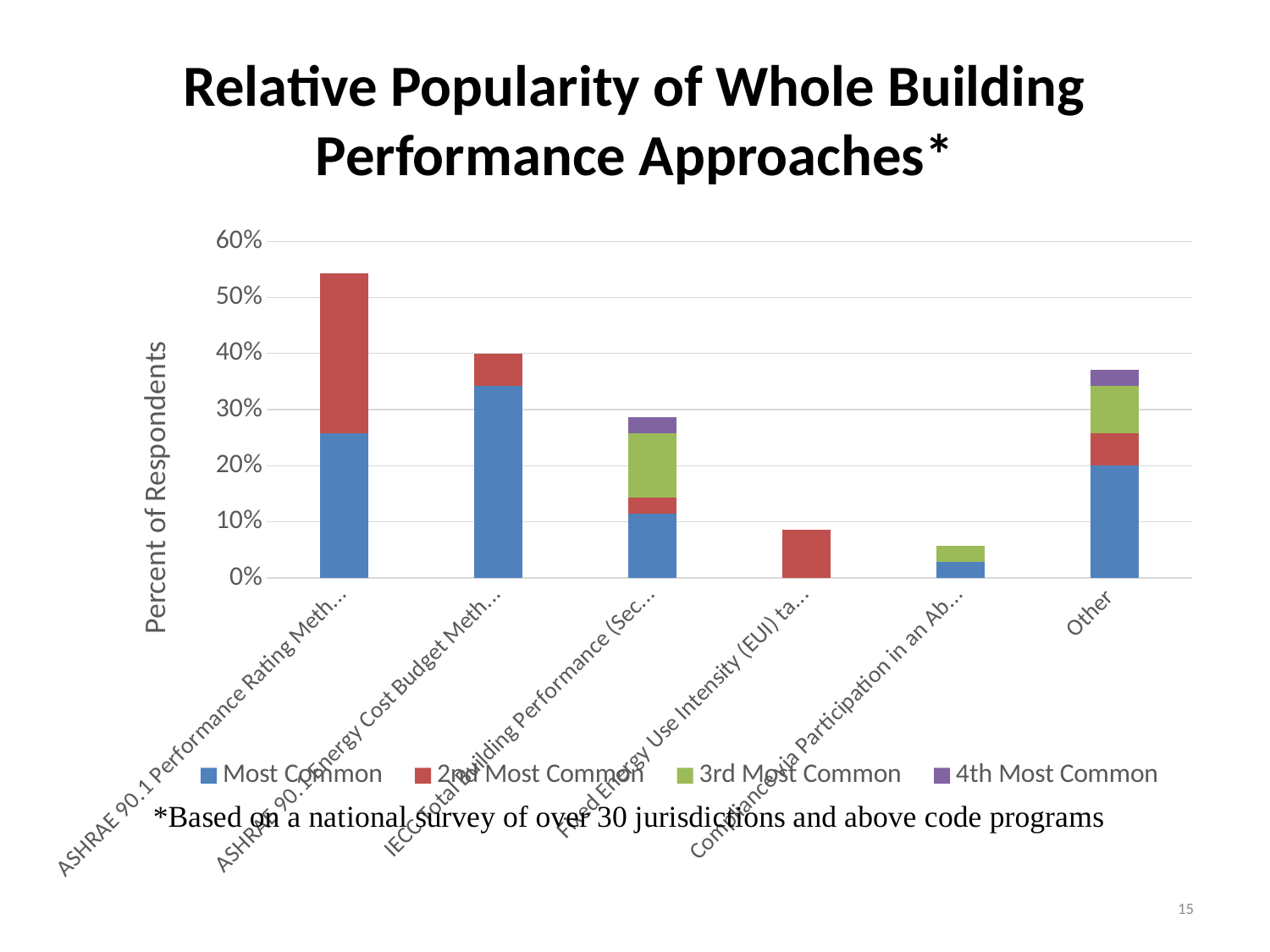
Which colour represents the '3rd Most Common' series in the legend? Green What kind of chart is shown on the slide? Stacked bar chart How many series does the legend list? 4 How many categories are shown on the x axis? 6 Which category has the tallest stacked bar overall? ASHRAE 90.1 Performance Rating Method What is the title of the y axis? Percent of Respondents Is the total stacked value for Other greater or less than 30%? greater Which has a larger total stacked bar, Other or IECC Total Building Performance? Other Is the total stacked value for ASHRAE 90.1 Performance Rating Method greater or less than 50%? greater Which category has the largest 'Most Common' segment? ASHRAE 90.1 Energy Cost Budget Method Is the 'Most Common' value for ASHRAE 90.1 Performance Rating Method greater or less than 20%? greater